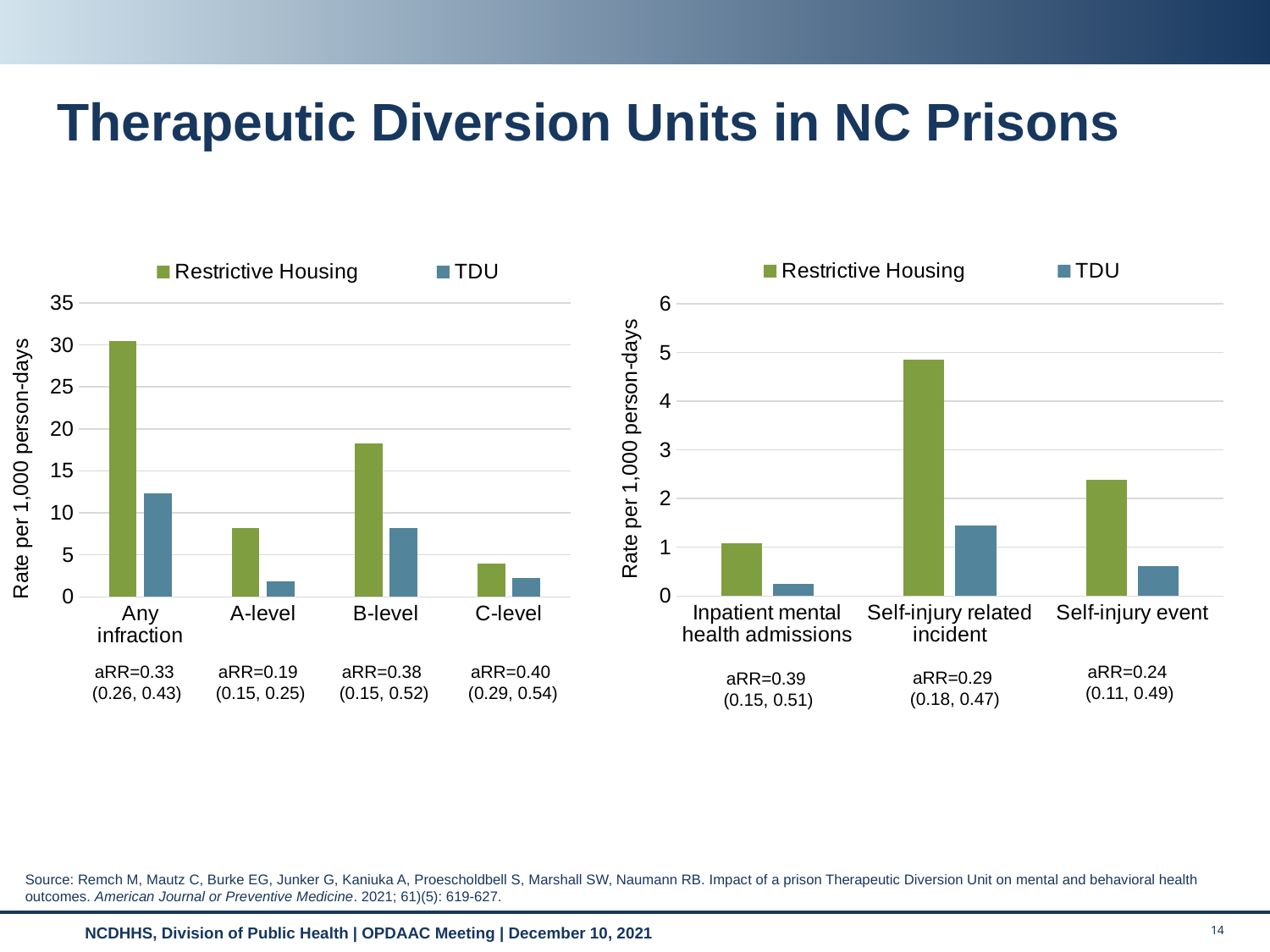
On the right chart, is the TDU value for Self-injury related incident greater or less than 2? less On the left chart, how many series does the legend list? 2 On the left chart, which category has the lowest TDU rate? A-level On the left chart, which is larger for B-level: Restrictive Housing or TDU? Restrictive Housing On the left chart, which category has the highest Restrictive Housing rate? Any infraction On the right chart, what is the label of the y axis? Rate per 1,000 person-days On the right chart, how many categories are shown on the x axis? 3 On the left chart, what kind of chart is shown? bar chart On the left chart, is the TDU value for B-level greater or less than 10? less On the left chart, how many categories are shown on the x axis? 4 On the right chart, which category has the highest Restrictive Housing rate? Self-injury related incident